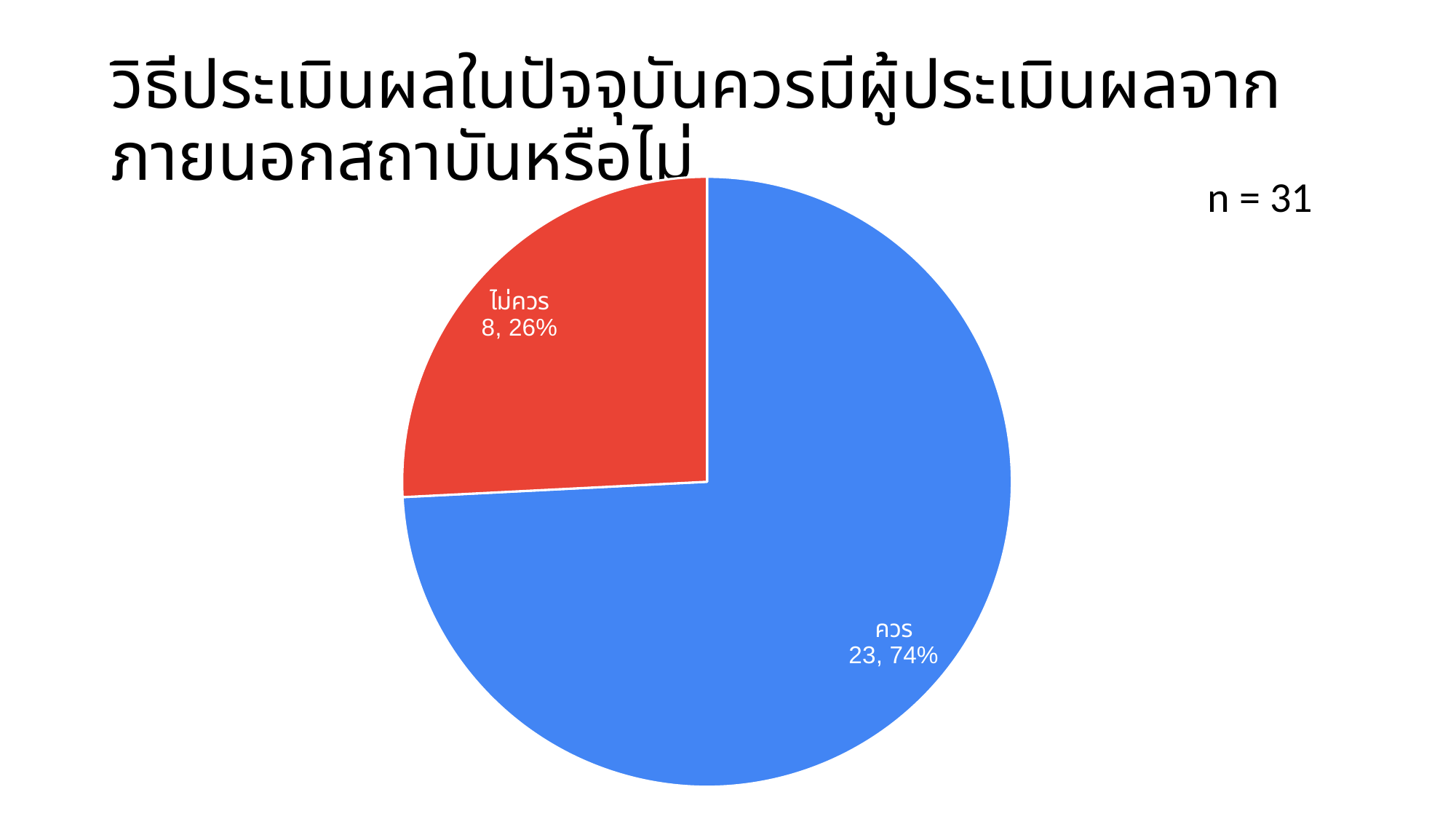
Which is larger, the ควร slice or the ไม่ควร slice? ควร Which slice is the smallest? ไม่ควร What share of the pie does the ควร slice represent? 74% How many slices does the pie chart have? 2 Which slice is the largest? ควร What is the count for the ไม่ควร slice? 8 What is the count for the ควร slice? 23 What kind of chart is shown on the slide? pie chart What colour is the ไม่ควร slice? red What share of the pie does the ไม่ควร slice represent? 26% What is the total count across both slices? 31 What is the difference in count between the ควร and ไม่ควร slices? 15